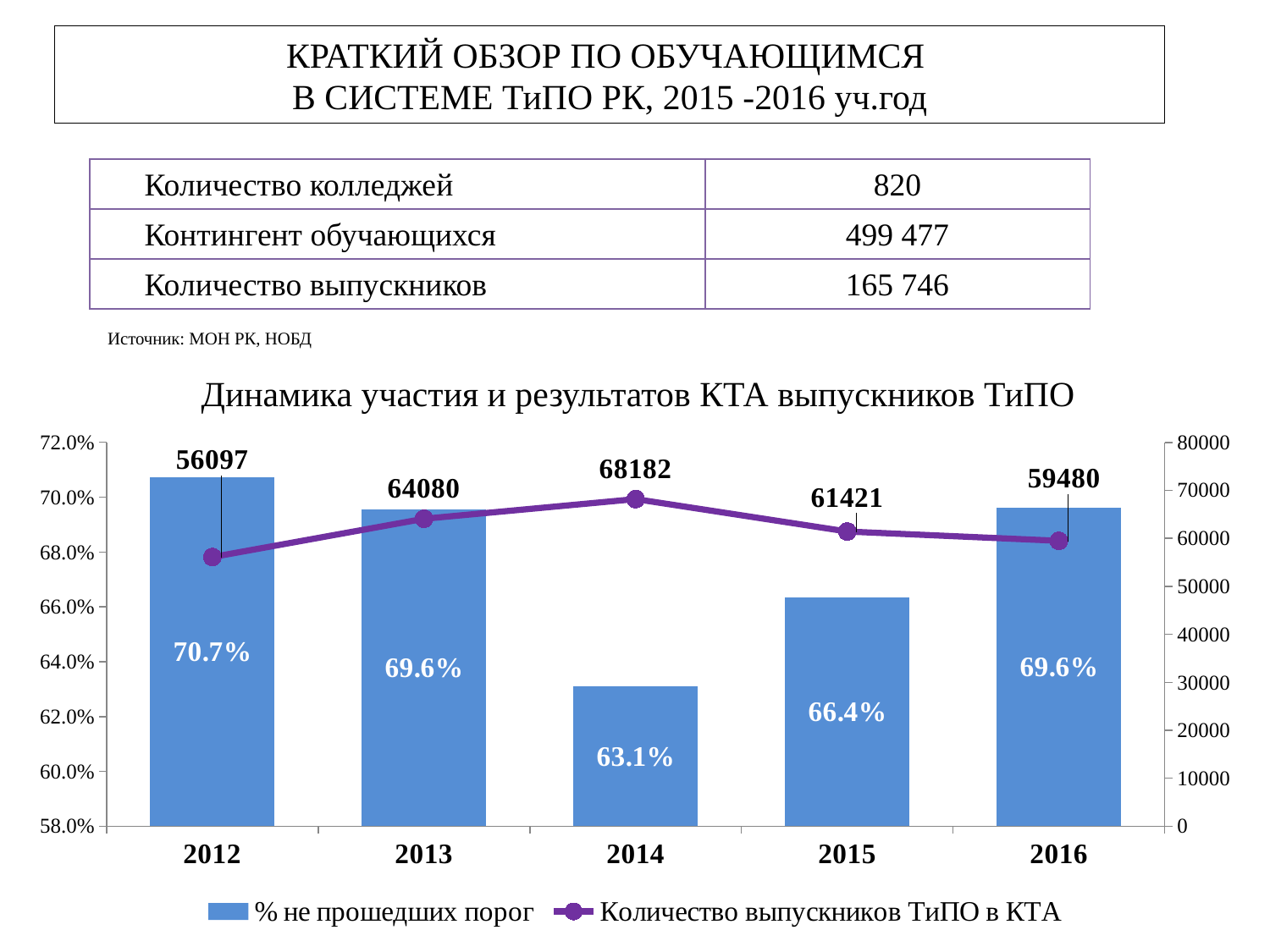
In which year is "% не прошедших порог" lowest? 2014 What is the difference between "Количество выпускников ТиПО в КТА" in 2014 and in 2012? 12085 What is the value of "% не прошедших порог" for 2012? 70.7% How many series does the chart legend list? 2 What is the title of the chart? Динамика участия и результатов КТА выпускников ТиПО In which year is "Количество выпускников ТиПО в КТА" lowest? 2012 In which year is "Количество выпускников ТиПО в КТА" highest? 2014 What is the value of "Количество выпускников ТиПО в КТА" for 2013? 64080 Which year has a larger "Количество выпускников ТиПО в КТА", 2015 or 2016? 2015 What is the difference between "% не прошедших порог" in 2012 and in 2015? 4.3% What is the value of "% не прошедших порог" for 2014? 63.1% How many years are shown on the x axis of the chart? 5